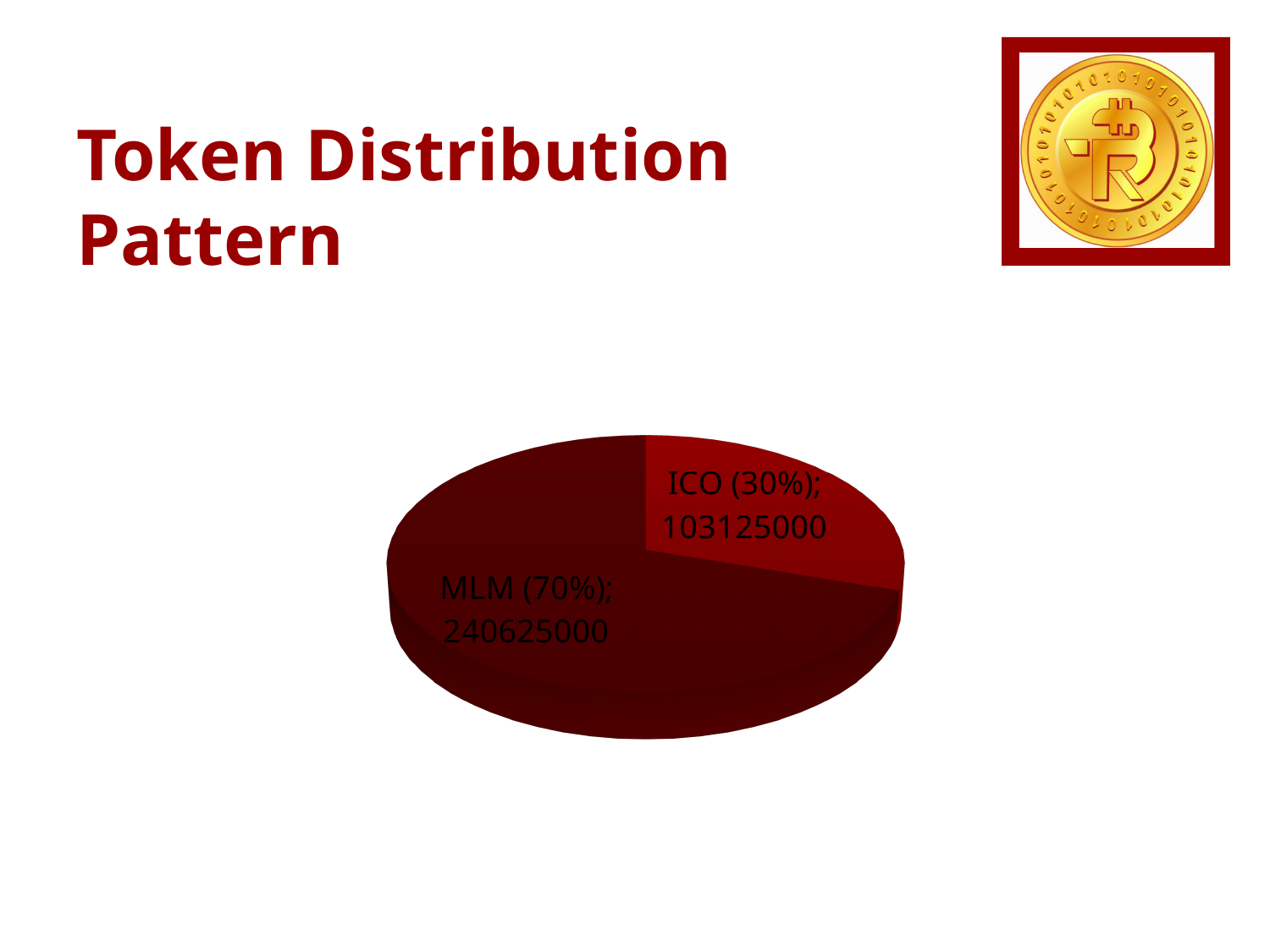
What is the title of the slide containing the pie chart? Token Distribution Pattern Which slice of the pie chart is the smallest? ICO What kind of chart is shown on the slide? pie chart Which slice of the pie chart is the largest? MLM Which is larger, the value for MLM or the value for ICO? MLM What is the total of the two slices in the pie chart? 343750000 What share of the pie does MLM represent? 70% What is the value for MLM in the pie chart? 240625000 How many slices does the pie chart have? 2 What share of the pie does ICO represent? 30% What is the value for ICO in the pie chart? 103125000 What is the difference between the MLM value and the ICO value? 137500000